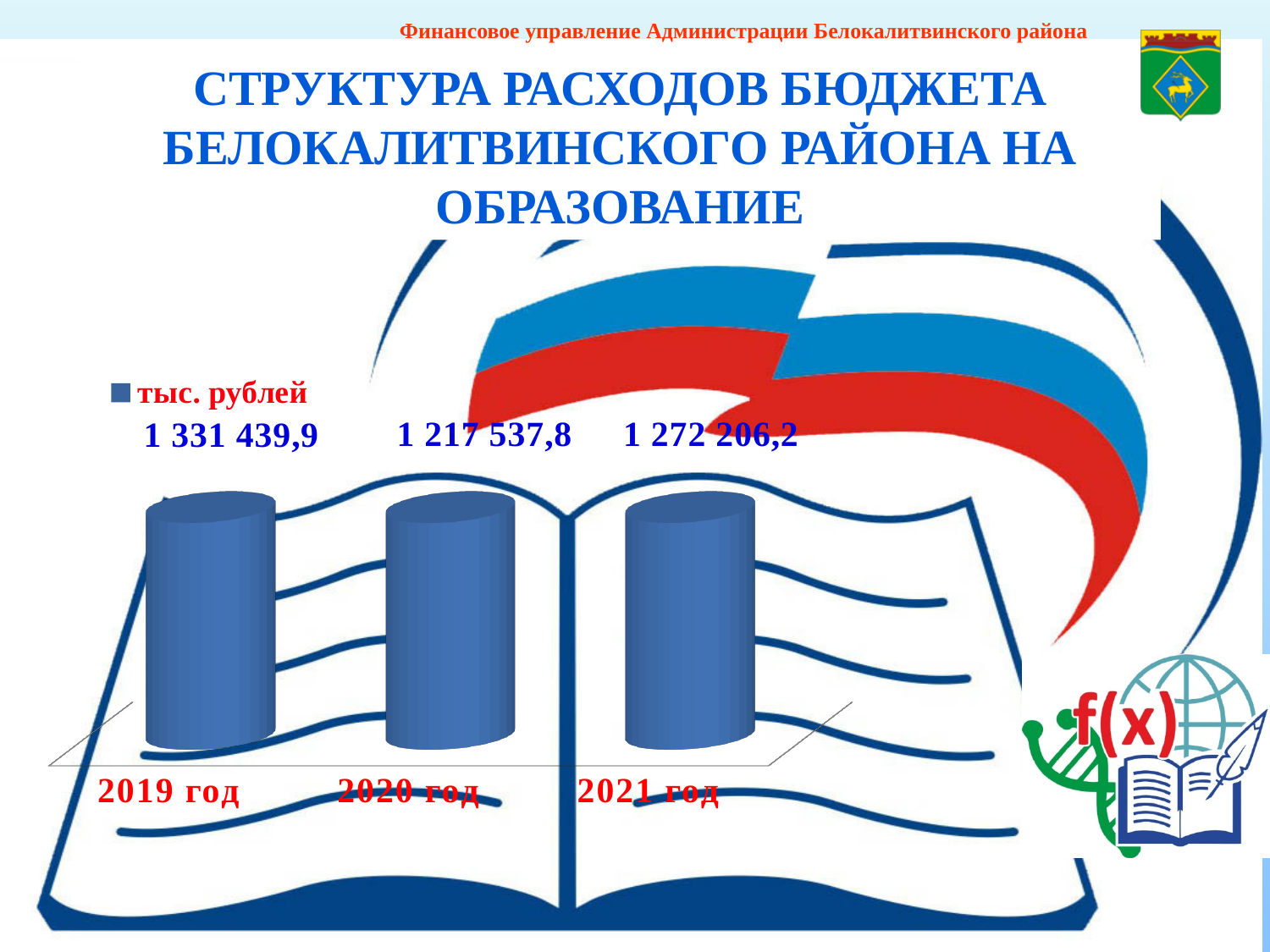
What is the value for 2021 год? 1 272 206,2 What is the difference between the values for 2019 год and 2020 год? 113 902,1 What is the legend entry of the chart? тыс. рублей What is the value for 2020 год? 1 217 537,8 How many series does the legend list? 1 How many categories are shown on the chart? 3 What kind of chart is shown on the slide? Bar chart What is the difference between the values for 2021 год and 2020 год? 54 668,4 What is the value for 2019 год? 1 331 439,9 Which year has the lowest value? 2020 год Which is larger, the value for 2021 год or the value for 2020 год? 2021 год Which year has the highest value? 2019 год